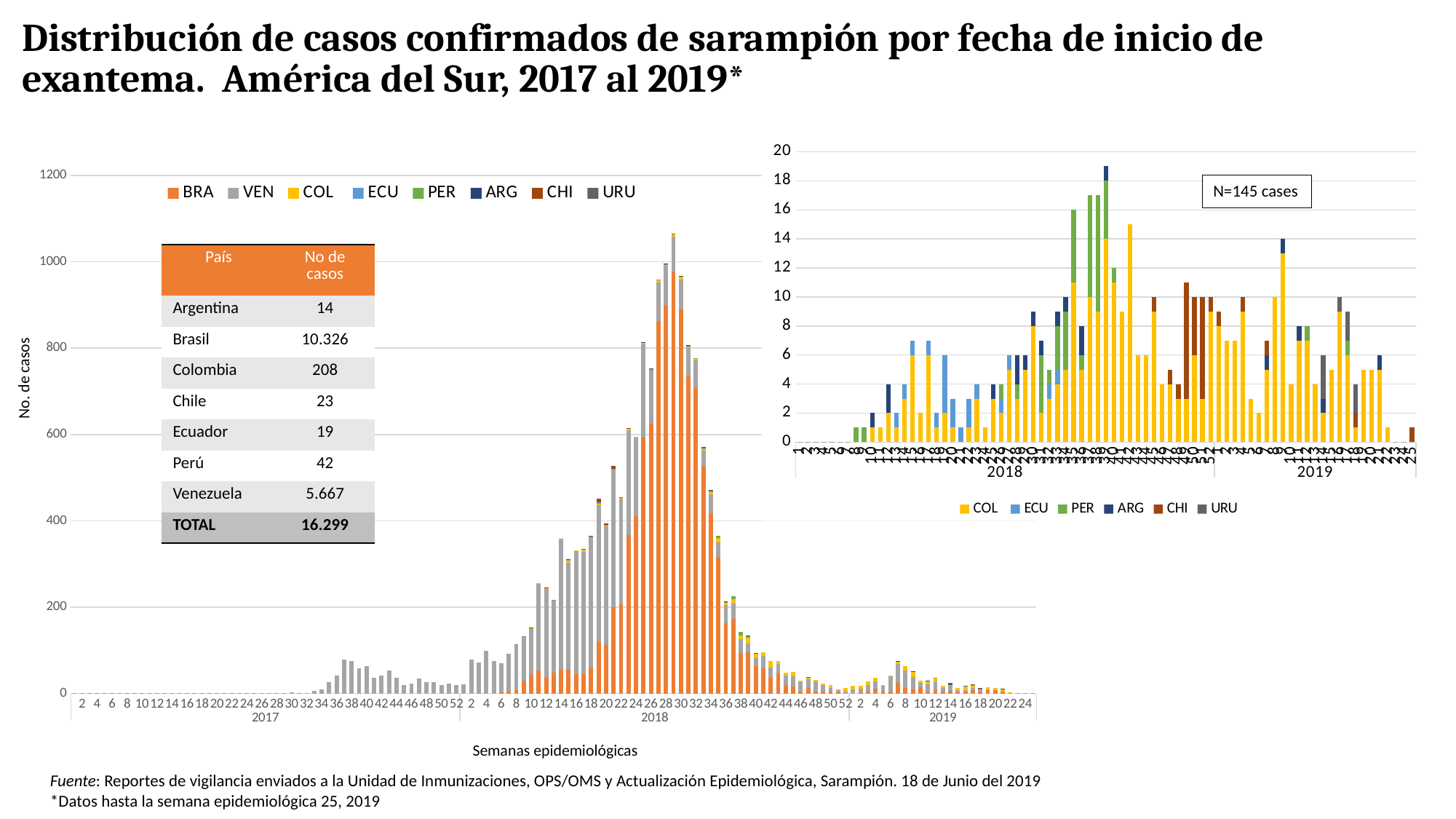
What is the highest value shown on the vertical axis of the inset chart on the right? 20 In the large chart on the left, which series makes up most of the tallest bars in 2018, BRA or VEN? BRA In the large chart on the left, in which year does the tallest bar occur? 2018 In the inset chart on the right, in which year does the tallest bar occur? 2018 In the large chart on the left, what is the label of the horizontal axis? Semanas epidemiológicas What type of chart is the large chart on the left of the slide? bar chart In the large chart on the left, is the tallest bar greater or less than 1000? greater How many series does the legend of the inset chart on the right list? 6 How many series does the legend of the large chart on the left list? 8 In the large chart on the left, do the bars rise or fall from week 30 of 2018 to week 52 of 2018? fall In the large chart on the left, what is the label of the vertical axis? No. de casos In the inset chart on the right, is the tallest bar greater or less than 16? greater